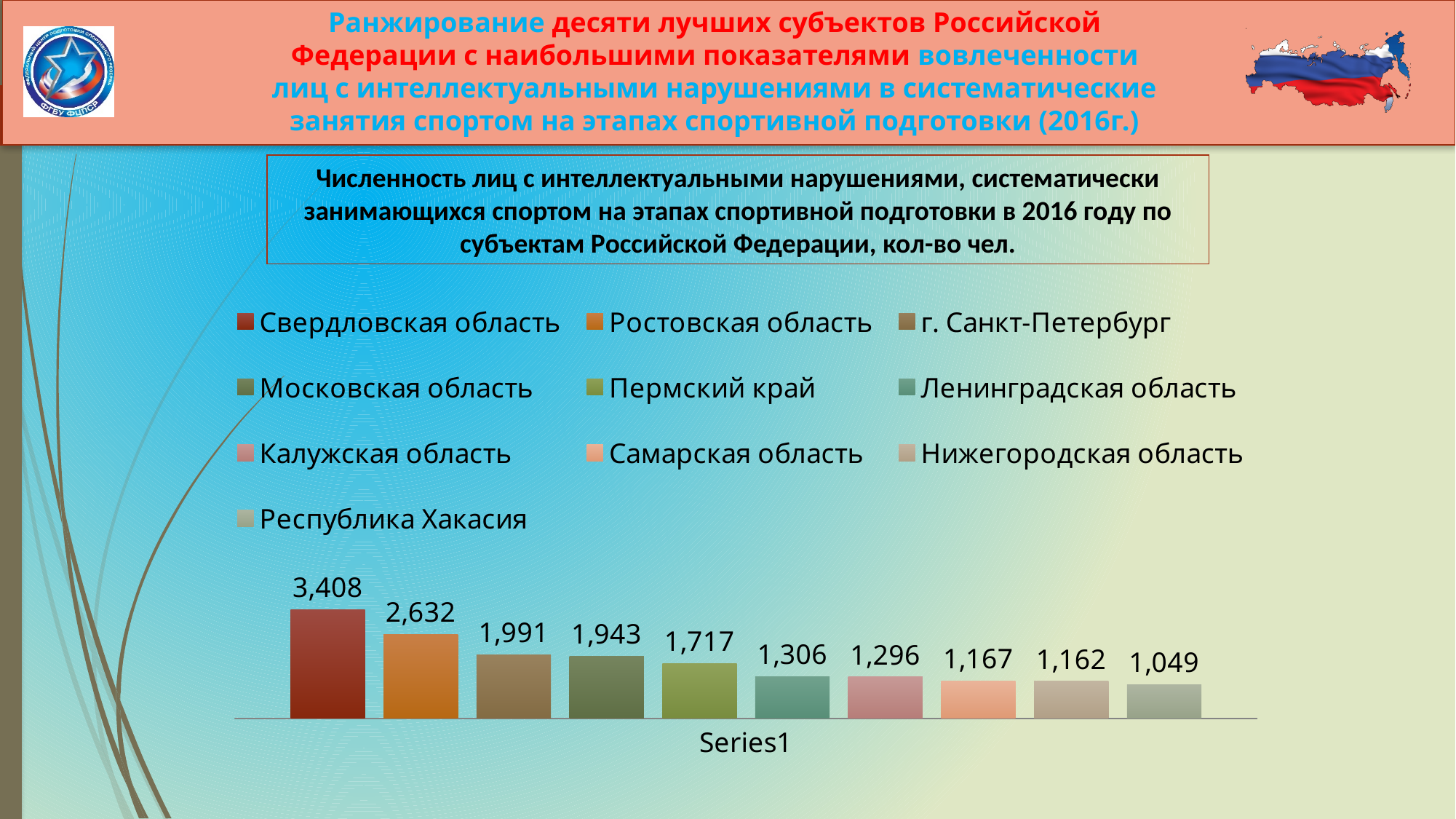
What is the value for Свердловская область? 3,408 Which region has the highest value? Свердловская область How many series does the legend list? 10 What is the difference between the values for Свердловская область and Ростовская область? 776 What is the value for Пермский край? 1,717 What kind of chart is shown? bar chart Which region has the lowest value? Республика Хакасия What is the value for Республика Хакасия? 1,049 Do the values rise or fall from left to right along the x axis? fall What is the value for Ростовская область? 2,632 What is the label shown on the x axis under the bars? Series1 Which is larger, the value for г. Санкт-Петербург or the value for Московская область? г. Санкт-Петербург